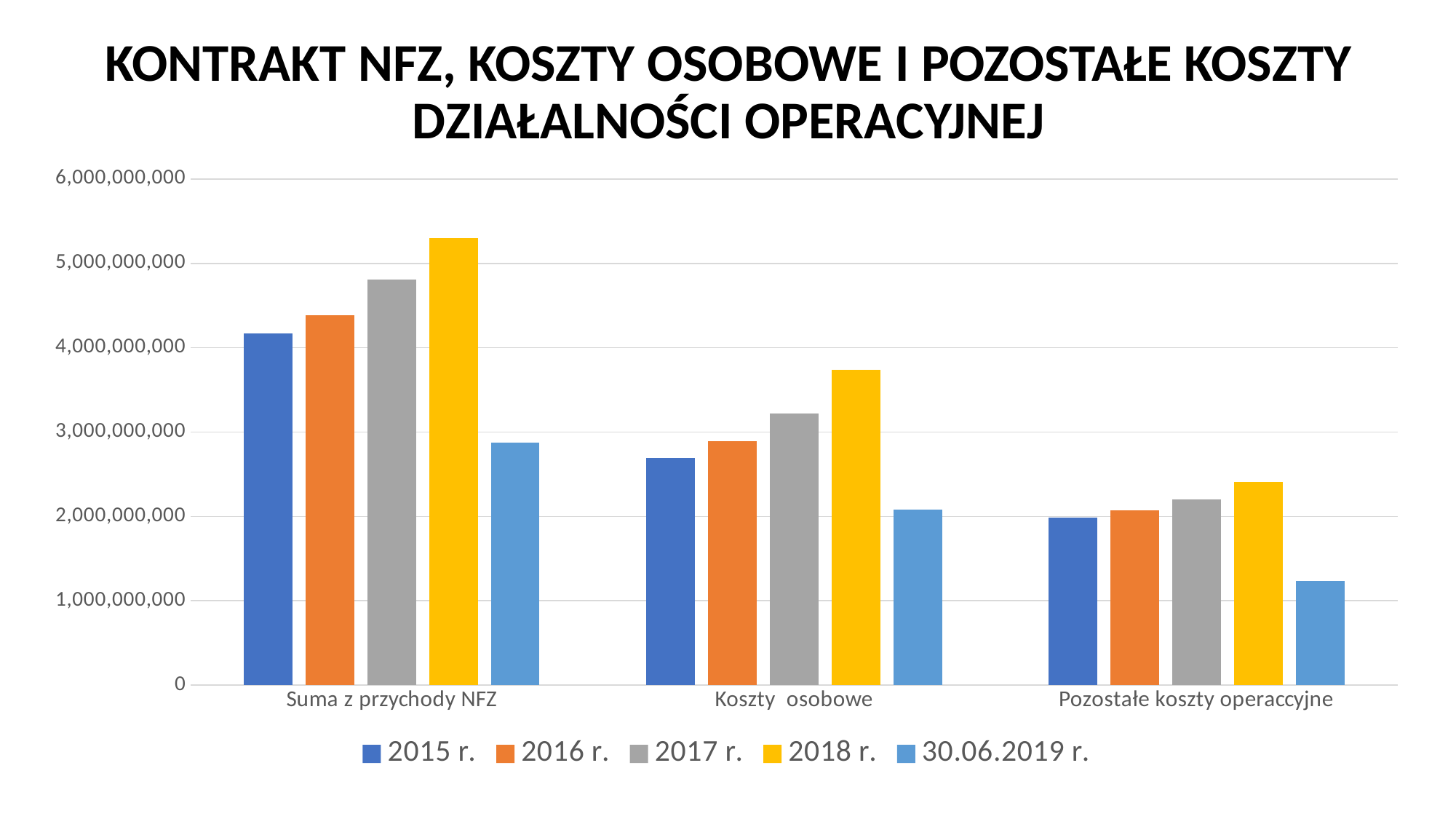
What kind of chart is shown on the slide? bar chart How many categories are shown on the x axis? 3 Which is larger: the 2017 r. bar for Koszty osobowe or the 2017 r. bar for Pozostałe koszty operaccyjne? Koszty osobowe Which series has the lowest bar in the Koszty osobowe category? 30.06.2019 r. Is the value for 30.06.2019 r. in Pozostałe koszty operaccyjne greater or less than 1,000,000,000? greater What colour are the bars for the 2018 r. series? yellow Is the value for 30.06.2019 r. in Suma z przychody NFZ greater or less than 3,000,000,000? less Do the values for Koszty osobowe rise or fall from 2015 r. to 2018 r.? rise How many series does the legend list? 5 Which series has the highest bar in the Suma z przychody NFZ category? 2018 r. Is the value for 2018 r. in Suma z przychody NFZ greater or less than 5,000,000,000? greater